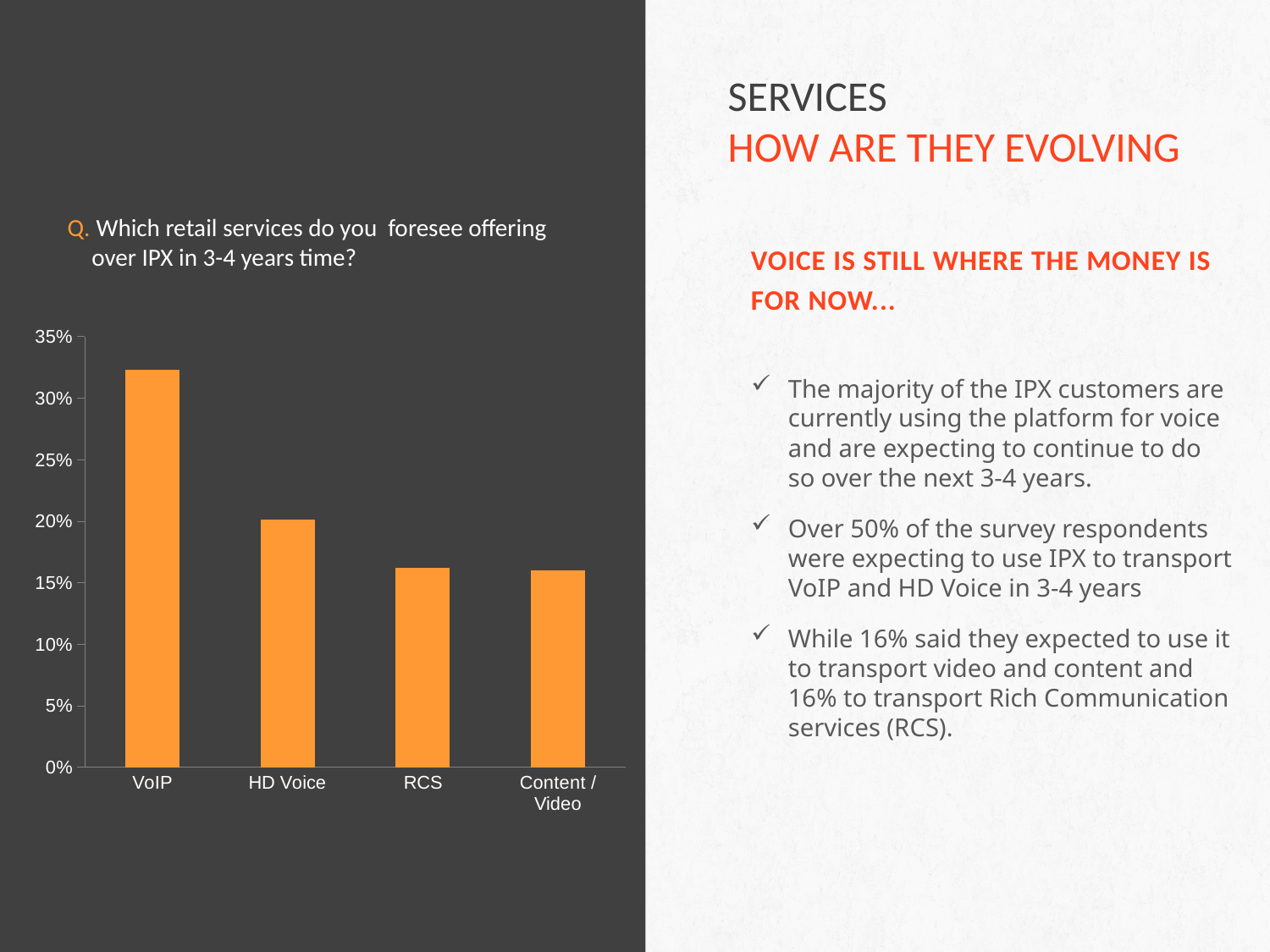
Which is larger, the value for HD Voice or the value for RCS? HD Voice What colour are the bars in the chart? orange Which is larger, the value for VoIP or the value for HD Voice? VoIP Is the value for VoIP greater or less than 30%? greater What kind of chart is shown on the slide? bar chart Which retail service has the highest bar in the chart? VoIP Is the value for VoIP greater or less than 35%? less How many retail service categories are shown on the x axis of the chart? 4 Is the value for RCS greater or less than 20%? less Do the bar values generally rise or fall moving from left to right along the x axis? fall